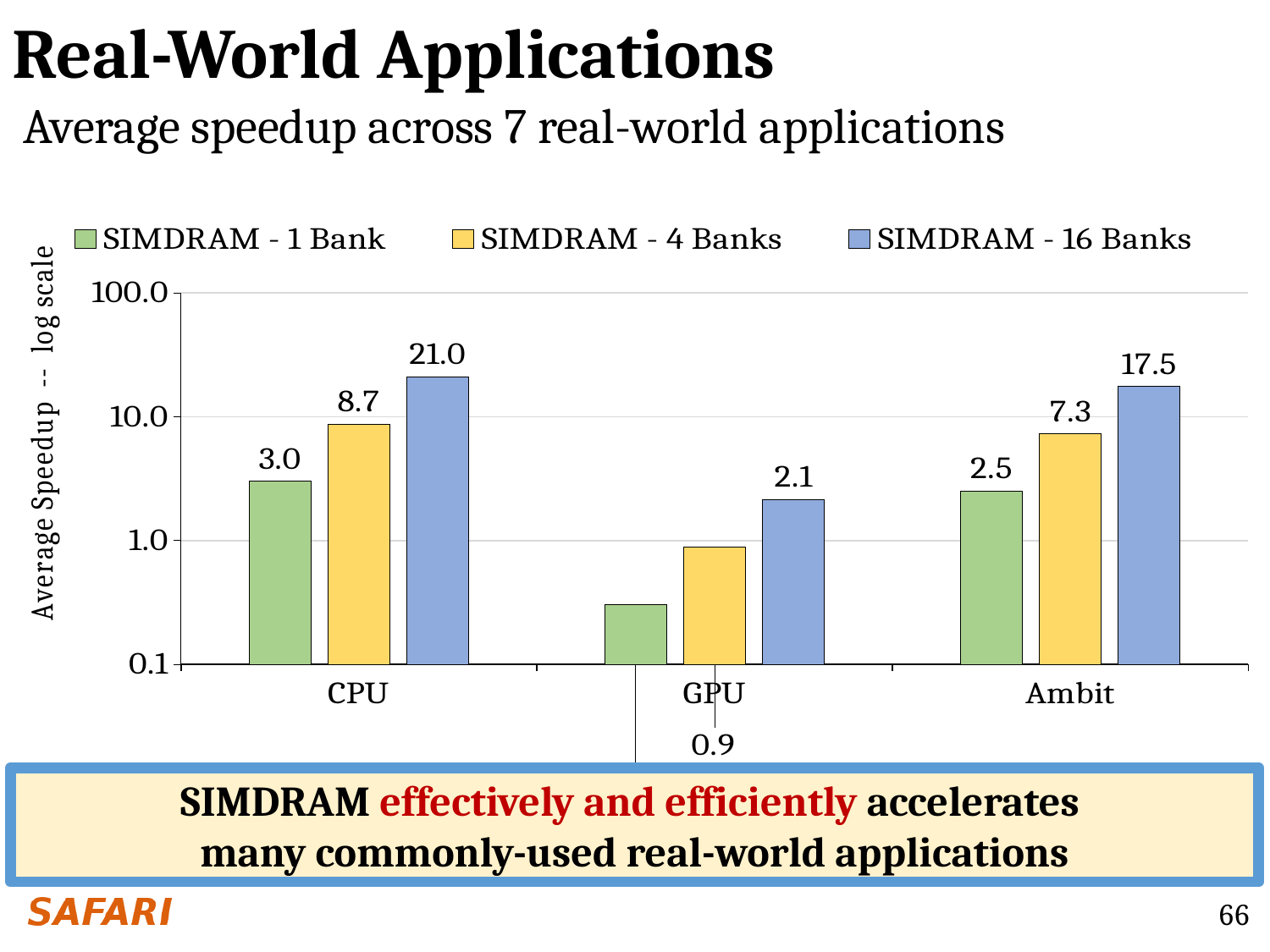
What is the average speedup for SIMDRAM - 1 Bank on CPU? 3.0 What is the difference between the SIMDRAM - 16 Banks speedup on CPU and on Ambit? 3.5 How many series does the legend list? 3 What is the average speedup for SIMDRAM - 16 Banks on CPU? 21.0 Which is larger: the SIMDRAM - 4 Banks speedup on CPU or on Ambit? CPU What is the average speedup for SIMDRAM - 16 Banks on GPU? 2.1 What kind of chart is shown on the slide? bar chart How many categories are shown on the x axis? 3 What is the average speedup for SIMDRAM - 4 Banks on Ambit? 7.3 Is the value for SIMDRAM - 1 Bank on GPU greater or less than 1.0? less Which baseline category has the highest SIMDRAM - 16 Banks speedup? CPU Which baseline category has the lowest SIMDRAM - 4 Banks speedup? GPU